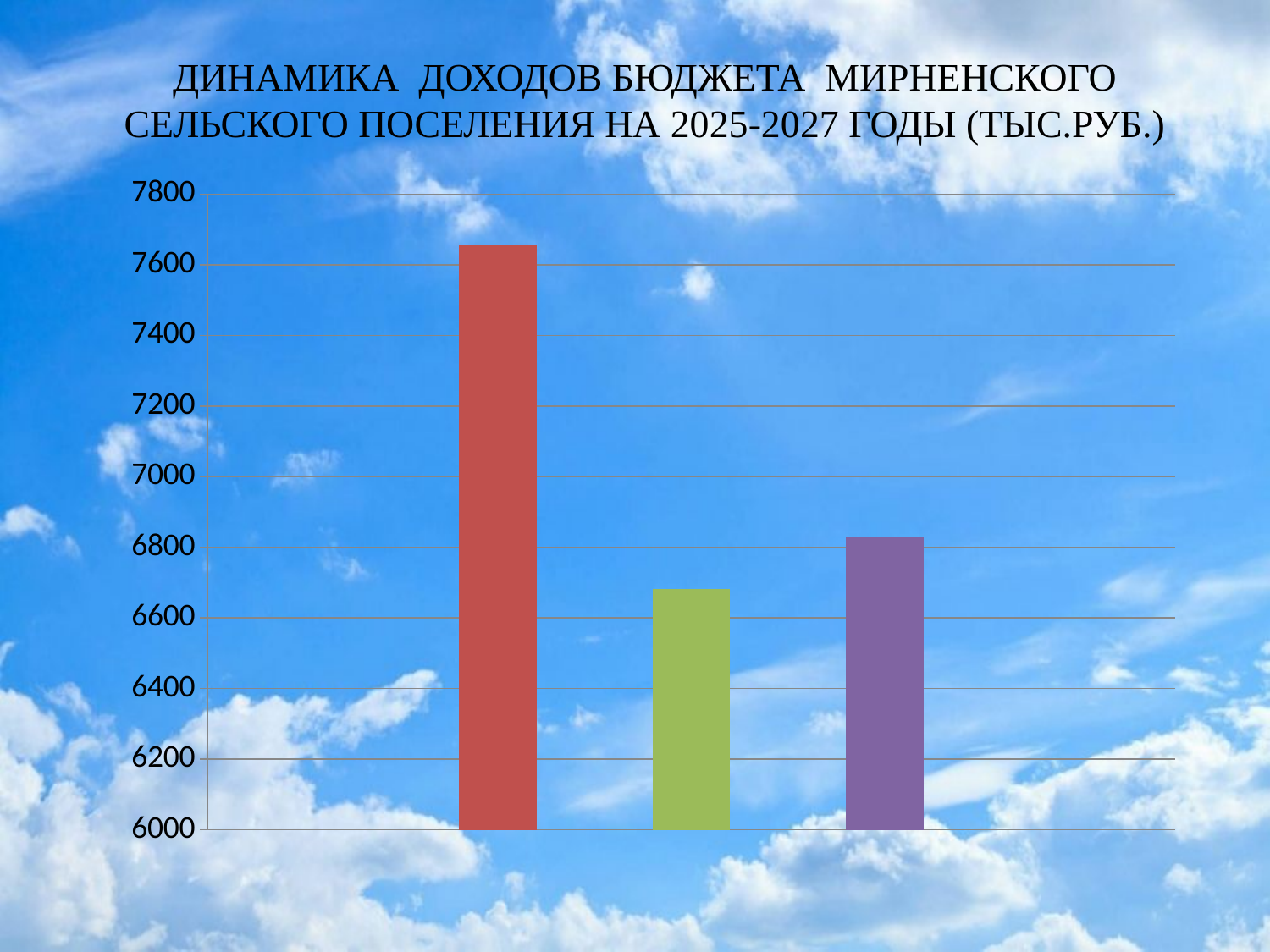
Is the value of the second (green) bar greater or less than 6800? less What unit of measurement is given in the chart title? тыс.руб. Is the value of the second (green) bar greater or less than 6600? greater What is the highest value shown on the vertical axis? 7800 How many bars are plotted in the chart? 3 Which bar is the highest: the first (red), second (green) or third (purple)? the first (red) Which bar is the lowest: the first (red), second (green) or third (purple)? the second (green) Which is larger, the second (green) bar or the third (purple) bar? the third (purple) bar Is the value of the first (red) bar greater or less than 7400? greater What kind of chart is shown on the slide? bar chart Which is larger, the first (red) bar or the third (purple) bar? the first (red) bar